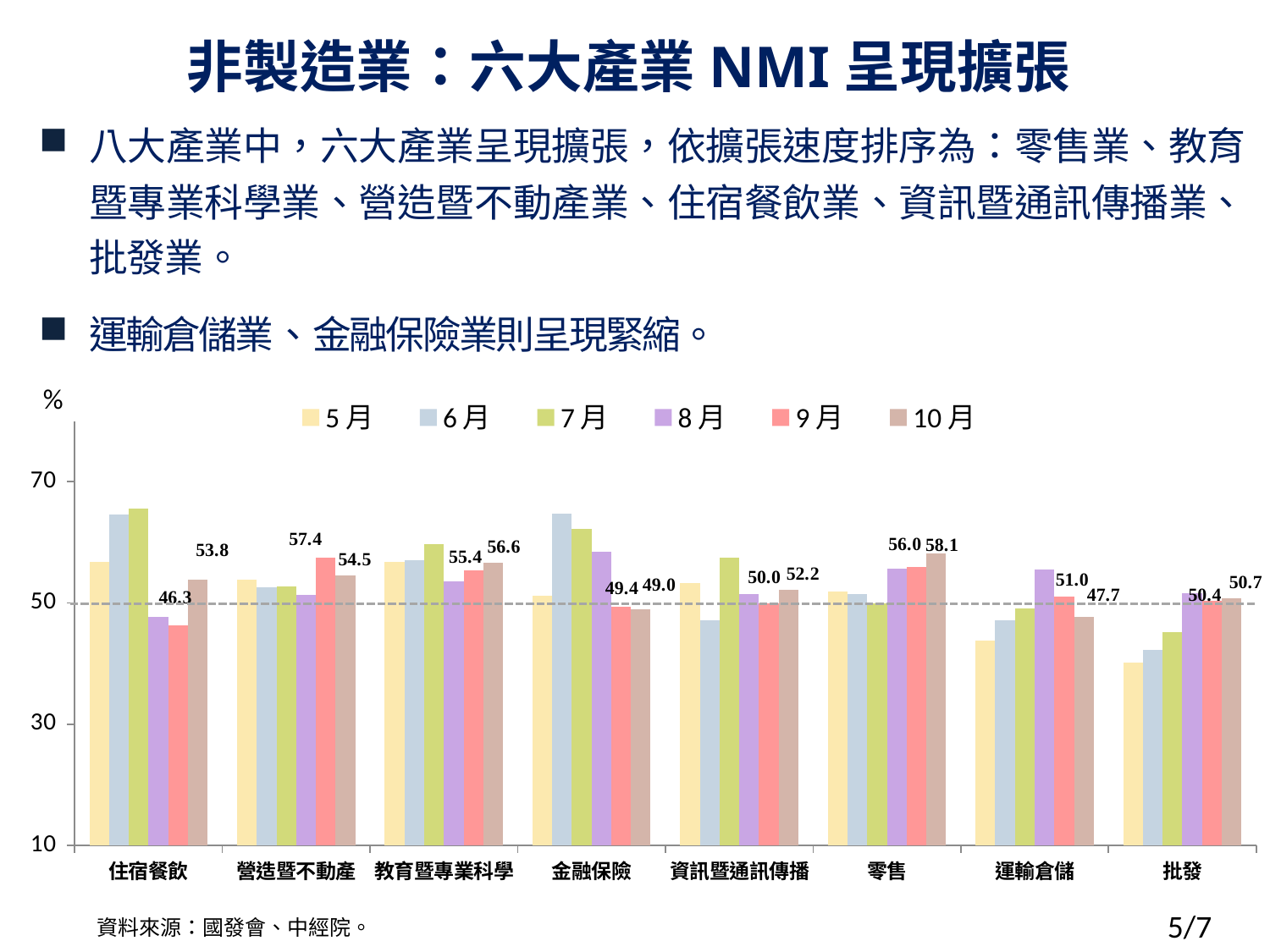
What is the difference between the 10月 and 9月 values for 住宿餐飲? 7.5 Which is larger for 營造暨不動產: the 9月 value or the 10月 value? 9月 What is the 10月 value for 零售? 58.1 What kind of chart is shown on the slide? Bar chart Which category has the highest 10月 value? 零售 Is the 6月 value for 金融保險 greater or less than 50? greater How many industry categories are shown on the x axis? 8 How many series does the legend list? 6 Is the 5月 value for 批發 greater or less than 50? less What is the 9月 value for 住宿餐飲? 46.3 What is the 10月 value for 運輸倉儲? 47.7 Which category has the lowest 9月 value? 住宿餐飲